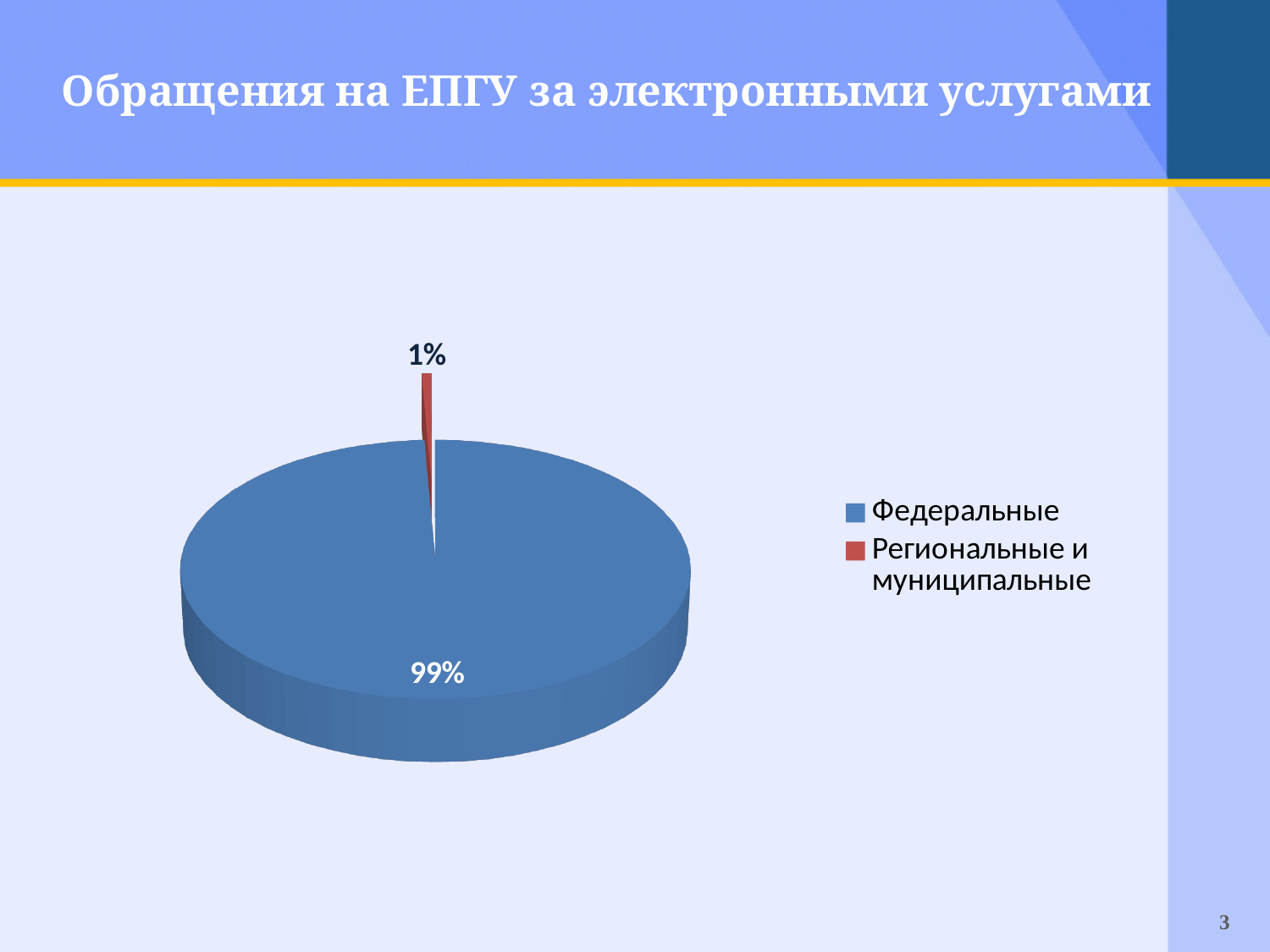
Which category has the smallest slice of the pie? Региональные и муниципальные What share of the pie does Федеральные take? 99% What share of the pie does Региональные и муниципальные take? 1% What colour is the Региональные и муниципальные slice? Red Which is larger, the Федеральные slice or the Региональные и муниципальные slice? Федеральные What is the title of the slide? Обращения на ЕПГУ за электронными услугами What is the difference in percentage points between the Федеральные and Региональные и муниципальные slices? 98 How many slices does the pie chart have? 2 Which category has the largest slice of the pie? Федеральные What kind of chart is shown on the slide? Pie chart How many entries does the legend list? 2